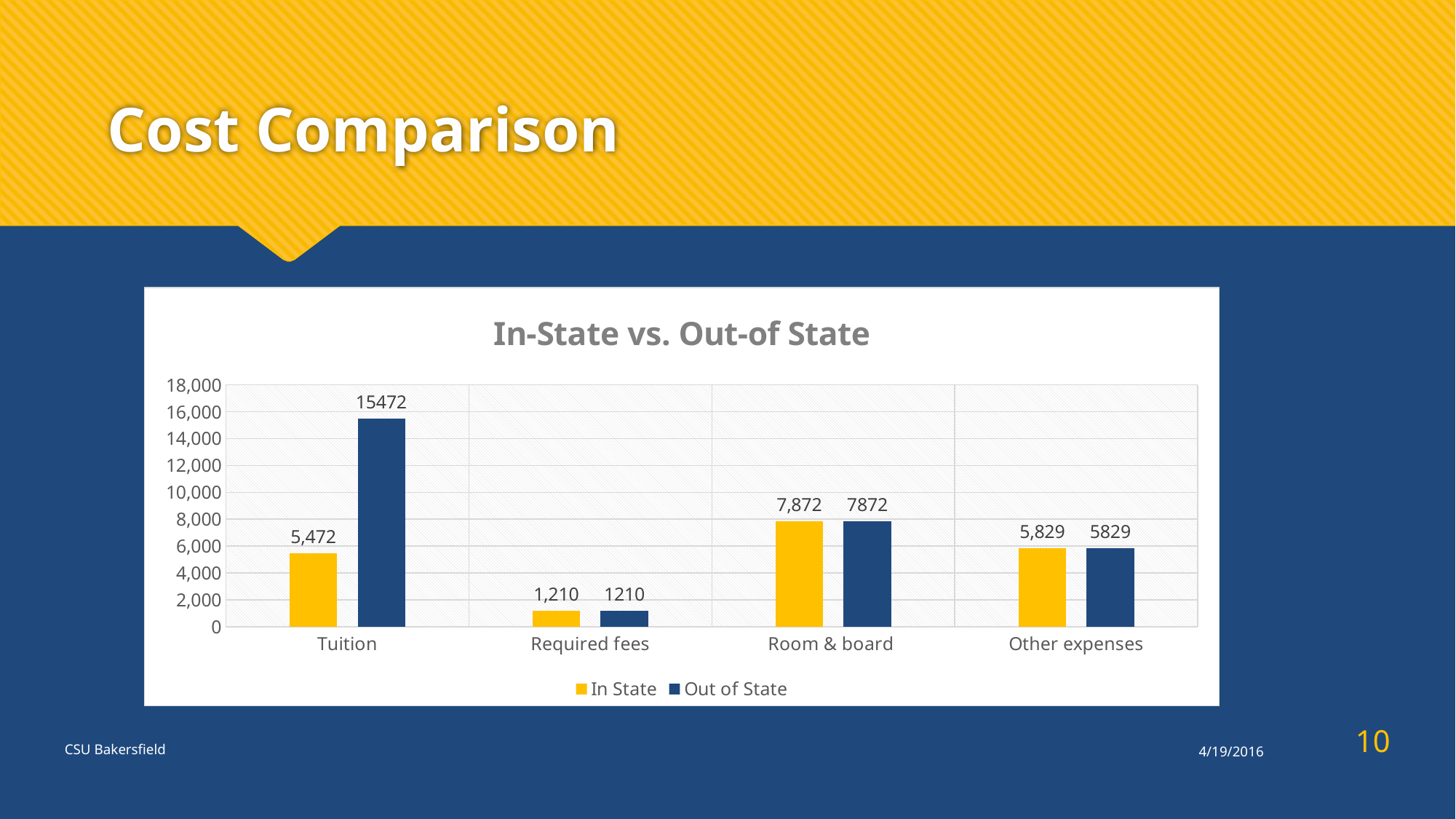
Which is larger for Room & board: the In State value or the Out of State value? They are equal What is the Out of State value for Tuition? 15472 Which category has the highest Out of State value? Tuition How many categories are shown on the x axis? 4 Which category has the lowest In State value? Required fees What is the difference between the Out of State and In State values for Tuition? 10,000 What is the In State value for Tuition? 5,472 What type of chart is shown? Bar chart How many series does the legend list? 2 What is the Out of State value for Other expenses? 5829 Is the Out of State value for Tuition greater or less than 14,000? greater What is the In State value for Room & board? 7,872